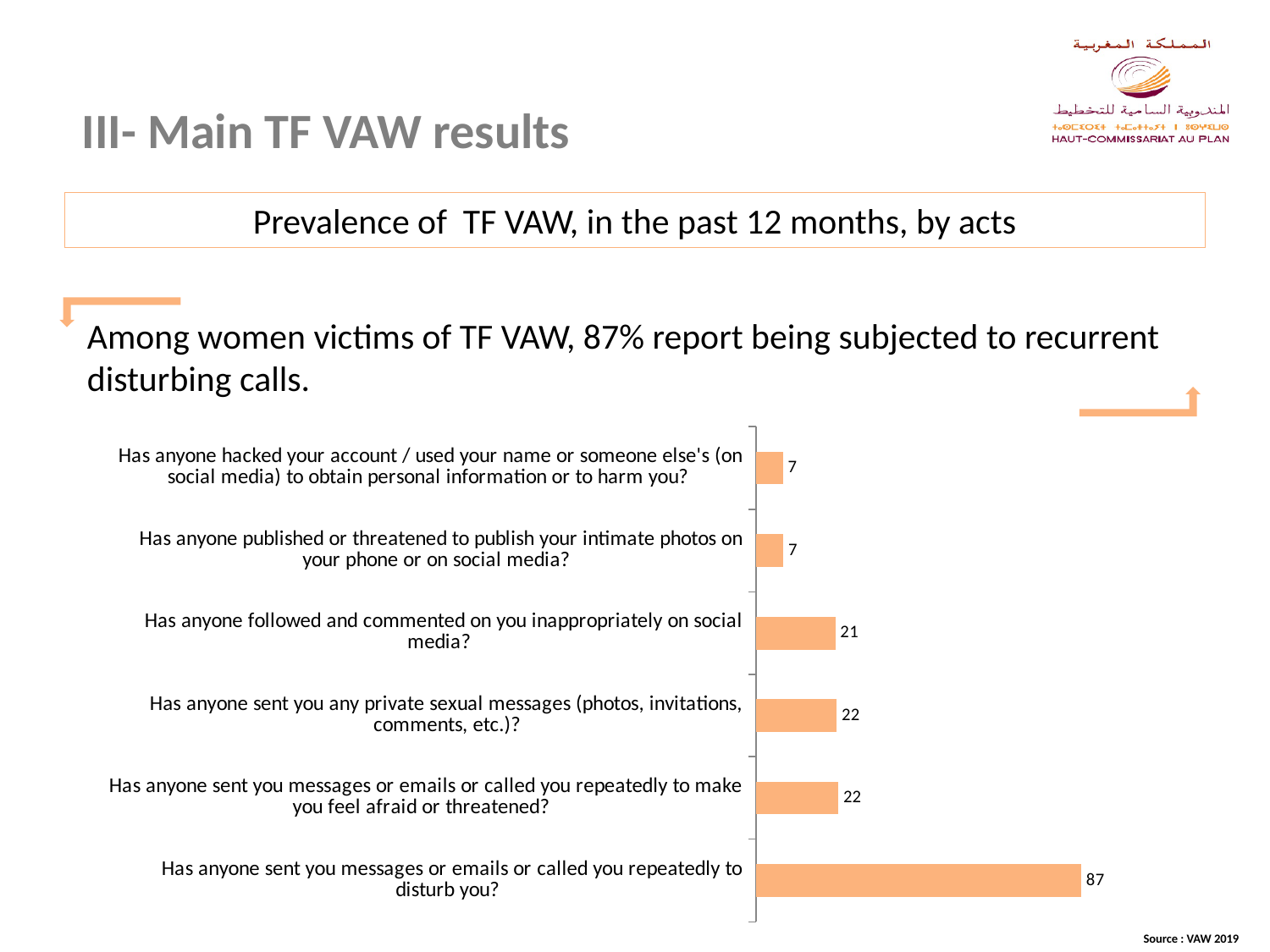
Which act has the highest value in the chart? Has anyone sent you messages or emails or called you repeatedly to disturb you? What value is shown for "Has anyone sent you messages or emails or called you repeatedly to disturb you?"? 87 What is the lowest value shown in the chart? 7 Which is larger: the value for private sexual messages or the value for having intimate photos published or threatened to be published? Private sexual messages What is the title of the chart on the slide? Prevalence of TF VAW, in the past 12 months, by acts What value is shown for "Has anyone sent you any private sexual messages (photos, invitations, comments, etc.)?"? 22 How many acts (categories) are shown in the chart? 6 What is the difference between the value for repeated messages/calls to disturb you (87) and the value for repeated messages/calls to make you feel afraid or threatened (22)? 65 What value is shown for "Has anyone followed and commented on you inappropriately on social media?"? 21 What type of chart is shown on the slide? Bar chart What value is shown for "Has anyone published or threatened to publish your intimate photos on your phone or on social media?"? 7 What is the difference between the value for being followed and commented on inappropriately on social media and the value for having your account hacked? 14